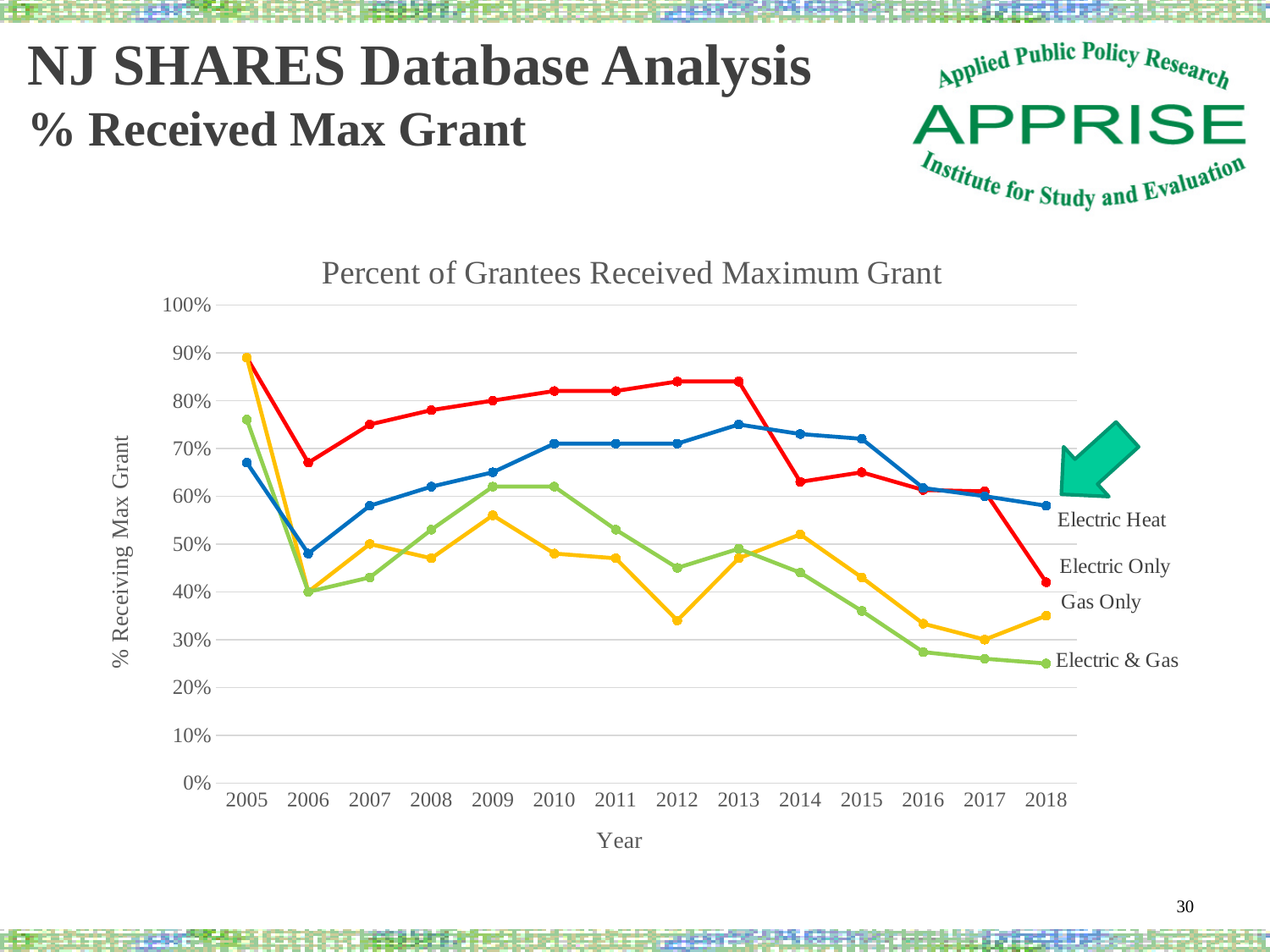
What kind of chart is shown on the slide? line chart Is the value for Electric Heat in 2013 greater or less than 70%? greater What is the label on the vertical axis of the chart? % Receiving Max Grant Is the value for Electric Only in 2018 greater or less than 50%? less Which series has the highest value in 2013? Electric Only Which series has the lowest value in 2018? Electric & Gas How many series are plotted in the chart? 4 What is the title of the chart? Percent of Grantees Received Maximum Grant How many years are shown on the x axis of the chart? 14 Is the value for Electric & Gas in 2018 greater or less than 30%? less In 2012, which is larger: Gas Only or Electric & Gas? Electric & Gas